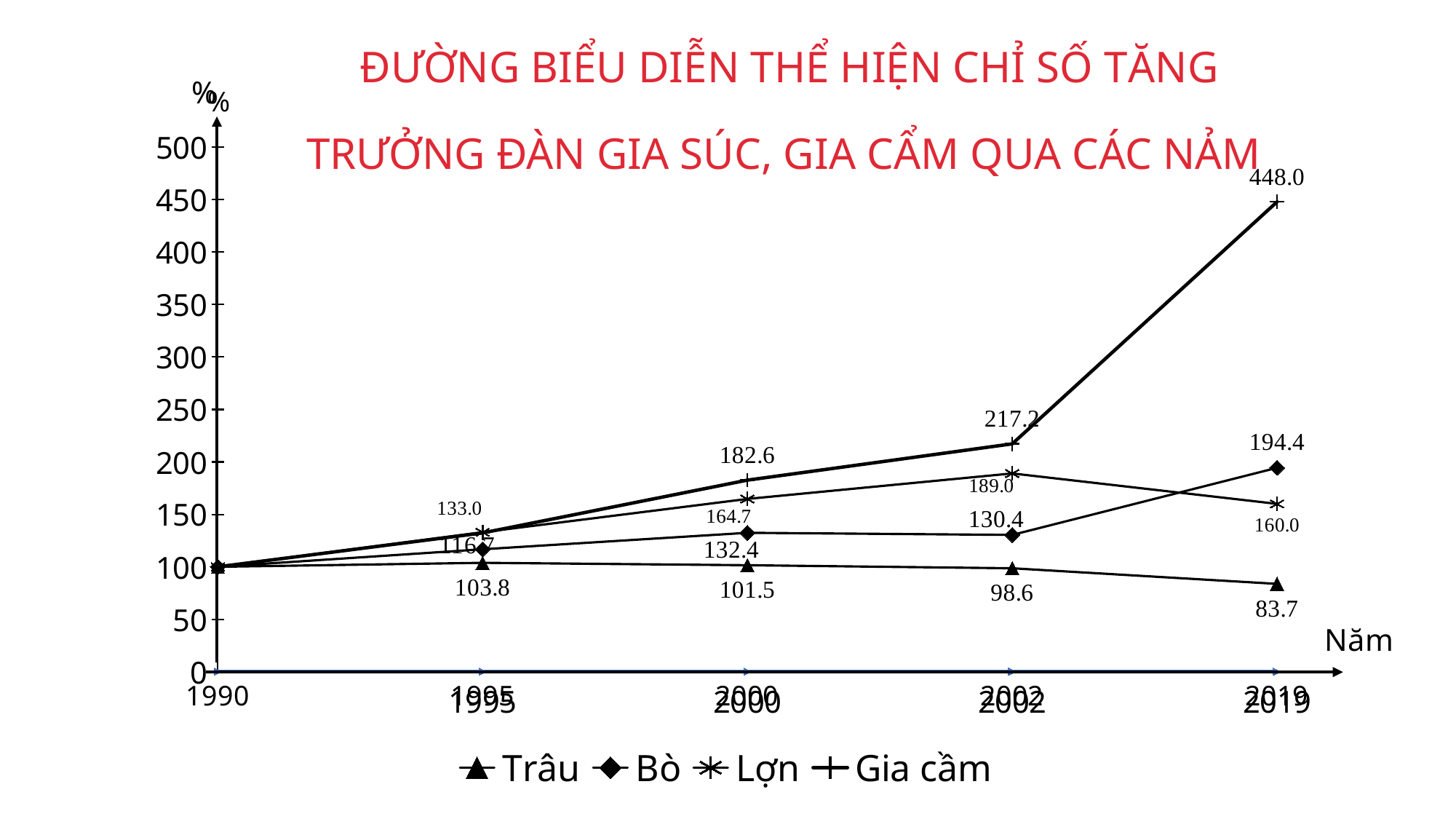
Which series has the highest value in 2019? Gia cầm How many series does the legend list? 4 Does the Trâu series rise or fall from 1995 to 2019? fall What is the value for Lợn in 2000? 164.7 Is the value for Gia cầm in 2019 greater or less than 400? greater In 2002, which is larger: the value for Lợn or the value for Bò? Lợn What kind of chart is shown on the slide? line chart What is the difference between the Gia cầm values in 2019 and 2002? 230.8 Which series has the lowest value in 2019? Trâu How many years are plotted along the x axis? 5 What is the value for Trâu in 2019? 83.7 What is the value for Gia cầm in 2019? 448.0